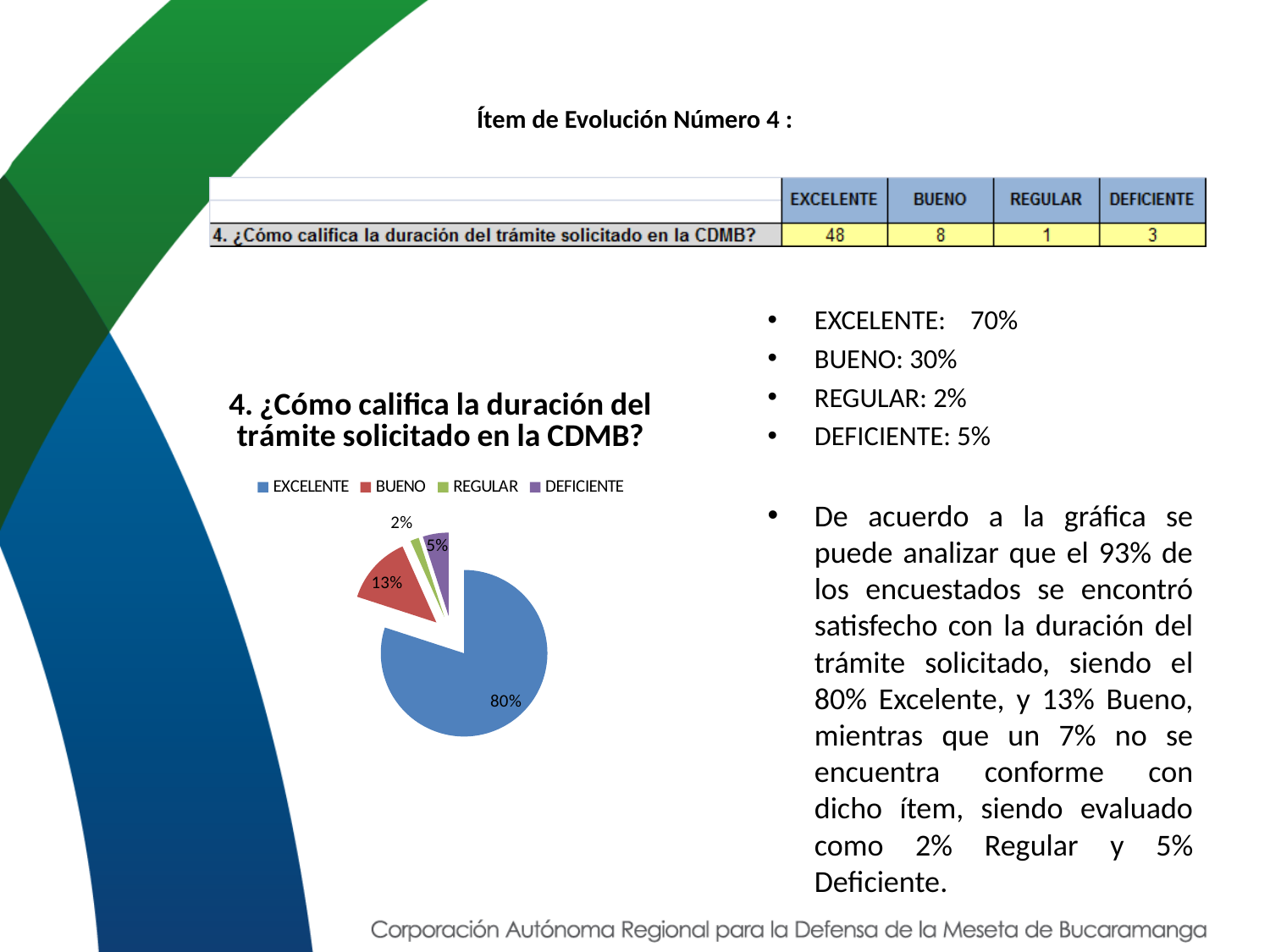
What percentage does the pie chart show for DEFICIENTE? 5% What percentage does the pie chart show for REGULAR? 2% Which category has the largest slice in the pie chart? EXCELENTE In the pie chart, which is larger: the slice for BUENO or the slice for DEFICIENTE? BUENO Which category has the smallest slice in the pie chart? REGULAR What percentage does the pie chart show for BUENO? 13% What type of chart is shown on the slide? pie chart What percentage does the pie chart show for EXCELENTE? 80% Which colour represents DEFICIENTE in the pie chart legend? purple What is the difference in percentage points between the EXCELENTE and BUENO slices in the pie chart? 67 How many categories does the pie chart legend list? 4 What is the title of the pie chart? 4. ¿Cómo califica la duración del trámite solicitado en la CDMB?